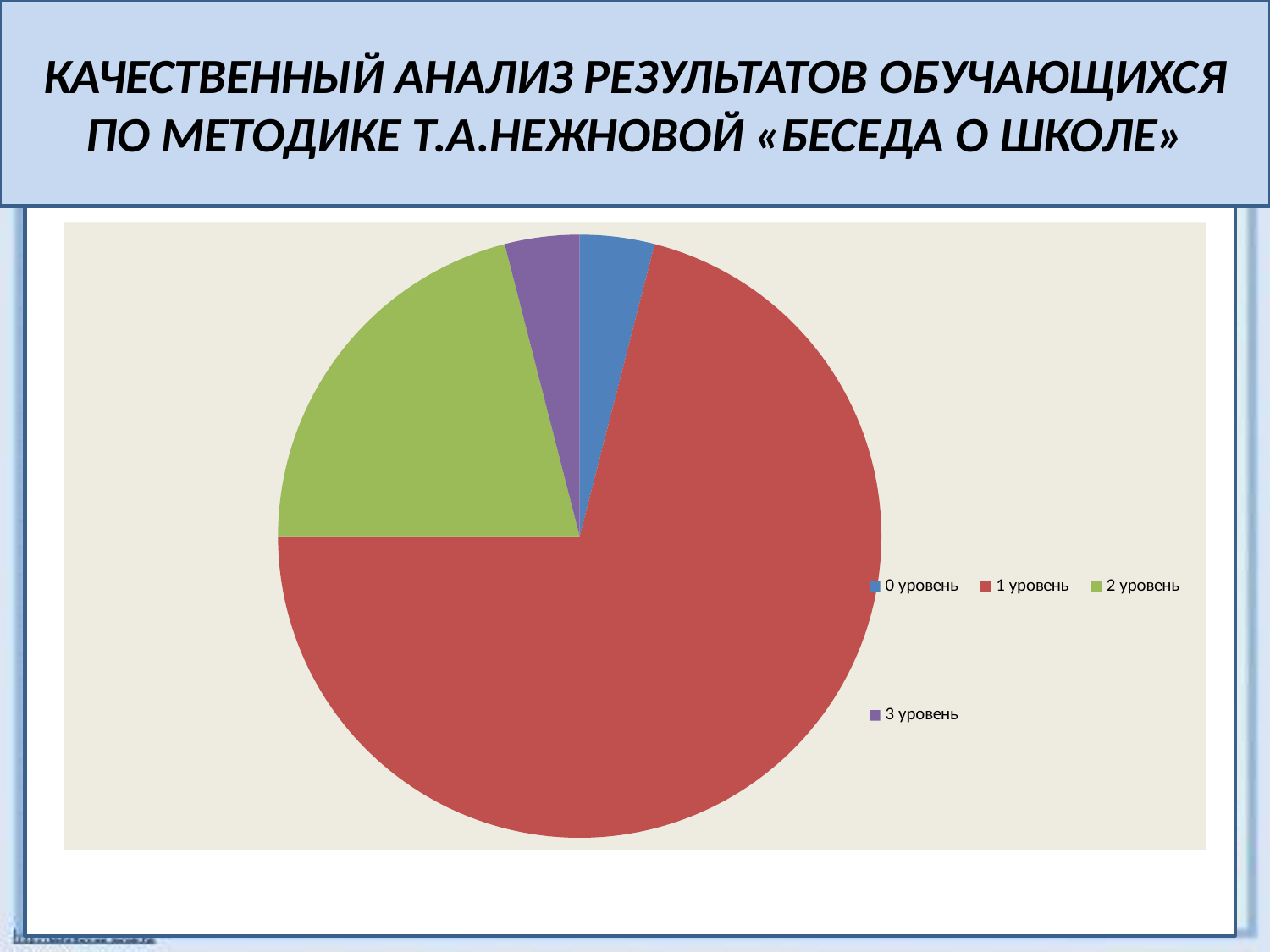
How many slices does the pie chart have? 4 Does the slice for 1 уровень take up more or less than half of the pie? more Which category has the largest slice of the pie chart? 1 уровень How many entries does the legend of the pie chart list? 4 Which slice is larger, 2 уровень or 0 уровень? 2 уровень Which slice is larger, 2 уровень or 3 уровень? 2 уровень What colour is the slice for 2 уровень in the pie chart? green What kind of chart is shown on the slide? pie chart What colour is the slice for 1 уровень in the pie chart? red Which slice is larger, 1 уровень or 2 уровень? 1 уровень